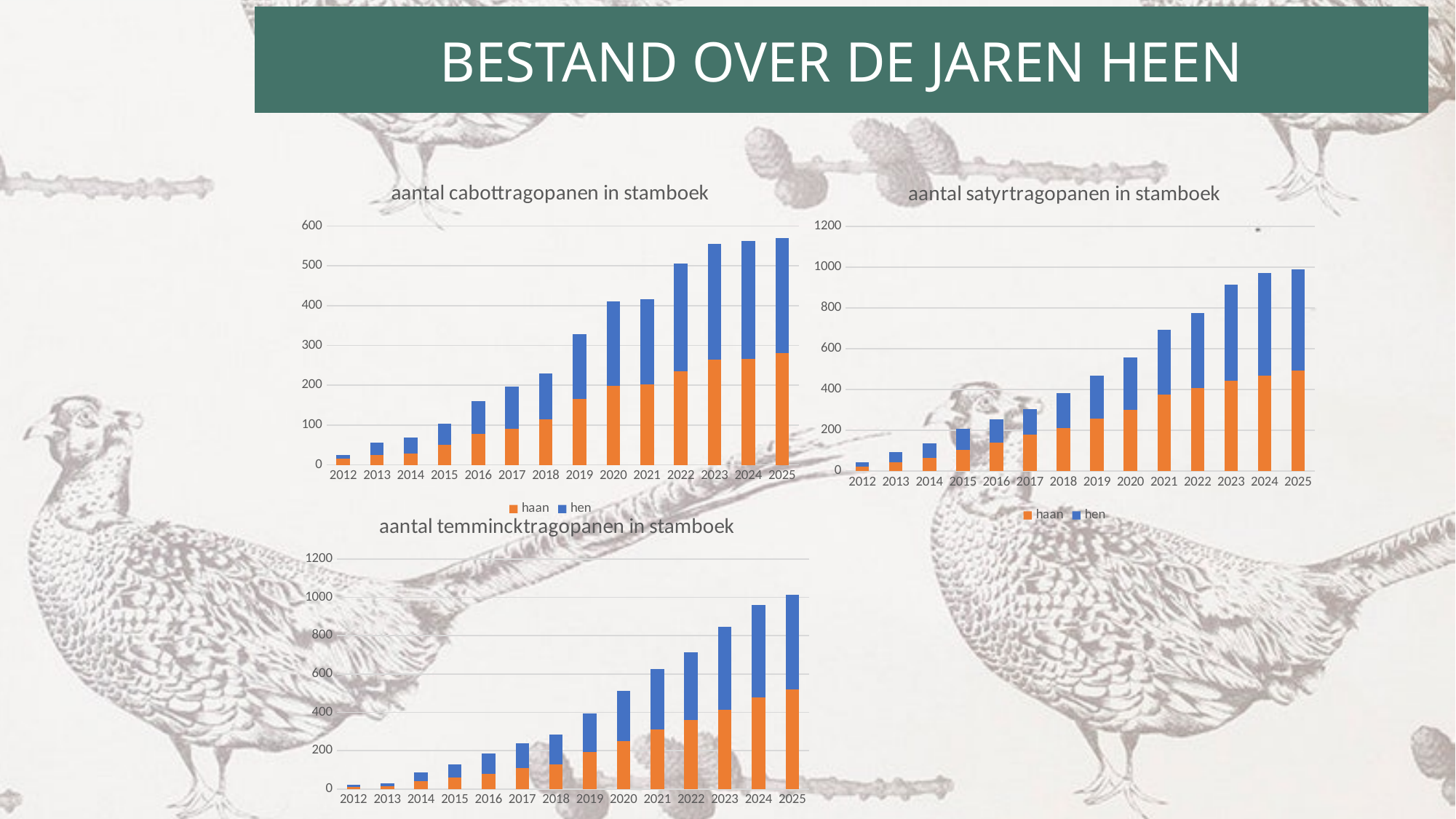
Do the totals in the 'aantal satyrtragopanen in stamboek' chart rise or fall from 2012 to 2025? rise In the 'aantal cabottragopanen in stamboek' chart, which year has the highest total? 2025 How many years are shown on the x axis of the 'aantal satyrtragopanen in stamboek' chart? 14 In the 'aantal cabottragopanen in stamboek' chart, which is larger, the total for 2019 or the total for 2020? 2020 In the 'aantal temmincktragopanen in stamboek' chart, is the total for 2023 greater or less than 800? greater What are the two legend entries in the 'aantal cabottragopanen in stamboek' chart? haan, hen How many series does the legend of the 'aantal temmincktragopanen in stamboek' chart list? 2 In the 'aantal temmincktragopanen in stamboek' chart, is the total for 2024 greater or less than 1000? less In the 'aantal satyrtragopanen in stamboek' chart, which year has the lowest total? 2012 What kind of chart is 'aantal cabottragopanen in stamboek'? stacked bar chart In the 'aantal cabottragopanen in stamboek' chart, is the total for 2019 greater or less than 300? greater